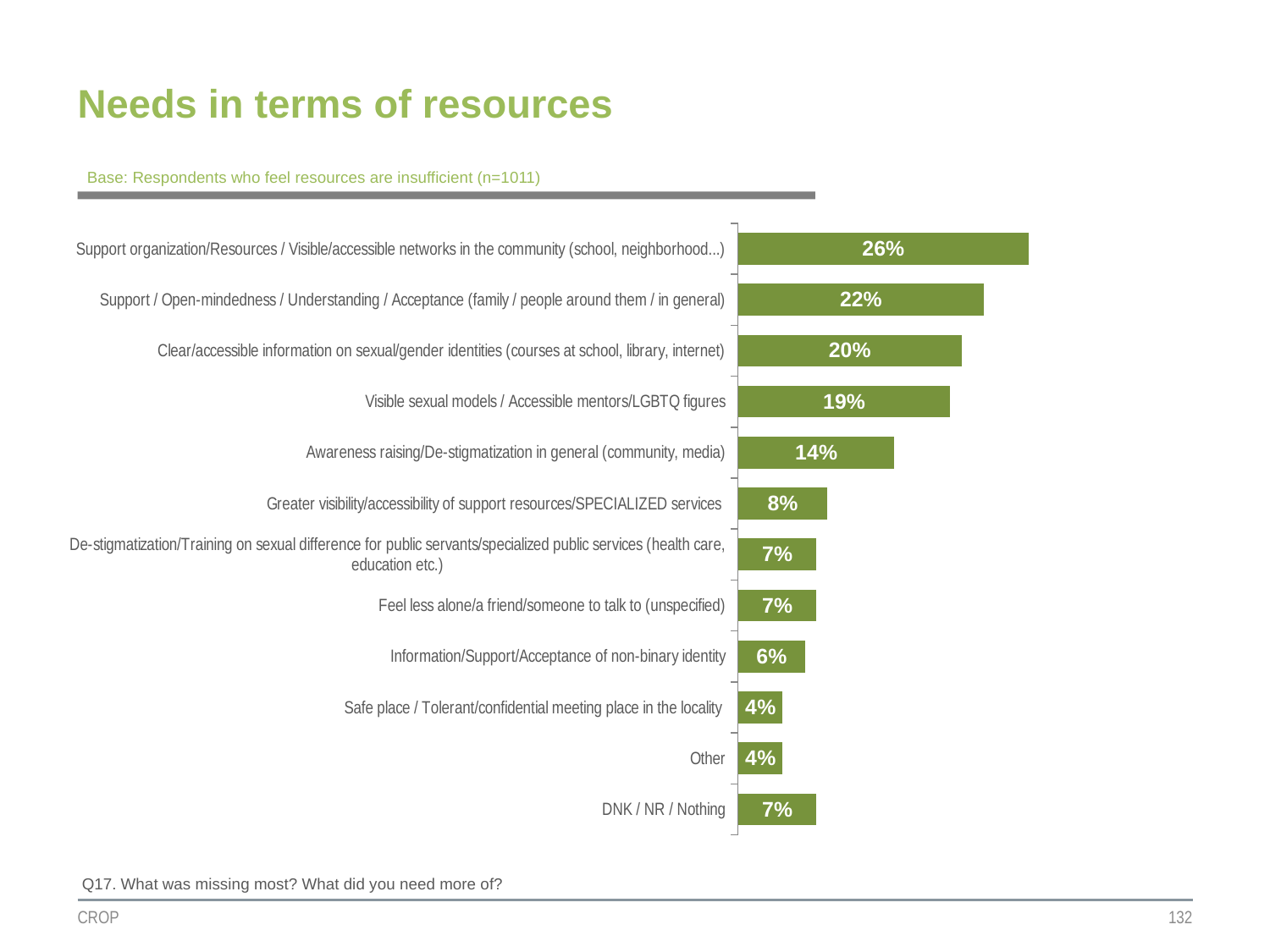
Which is larger: the value for 'Greater visibility/accessibility of support resources/SPECIALIZED services' or the value for 'Safe place / Tolerant/confidential meeting place in the locality'? Greater visibility/accessibility of support resources/SPECIALIZED services What is the base of respondents stated for the chart? Respondents who feel resources are insufficient (n=1011) What is the lowest value shown in the chart? 4% What is the value for 'Awareness raising/De-stigmatization in general (community, media)'? 14% What is the difference between the highest value and the value for 'DNK / NR / Nothing'? 19% How many categories are shown in the chart? 12 What percentage is shown for 'Information/Support/Acceptance of non-binary identity'? 6% What percentage of respondents cited 'Visible sexual models / Accessible mentors/LGBTQ figures' as a need? 19% What is the value of the highest bar in the chart? 26% What is the difference between the values for 'Support / Open-mindedness / Understanding / Acceptance (family / people around them / in general)' and 'Clear/accessible information on sexual/gender identities (courses at school, library, internet)'? 2% Which category has the highest value in the chart? Support organization/Resources / Visible/accessible networks in the community (school, neighborhood...) What type of chart is shown on the slide? Bar chart